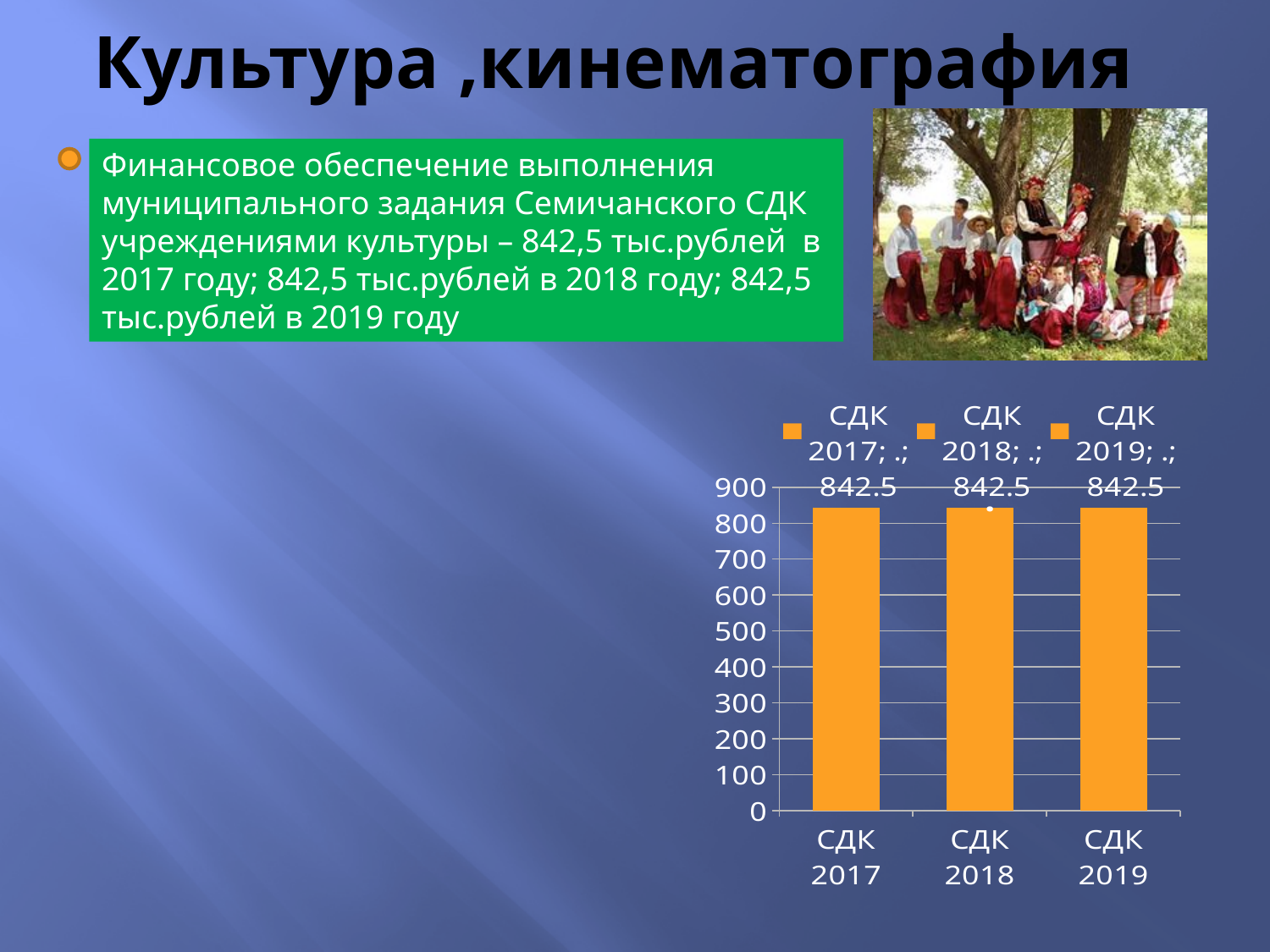
What is the difference between the values for СДК 2018 and СДК 2017? 0 What colour are the bars in the chart? orange What is the highest tick value shown on the vertical axis of the chart? 900 How many bars are plotted in the chart? 3 What is the value for СДК 2018 in the bar chart? 842.5 Do the values rise, fall or stay the same from СДК 2017 to СДК 2019? stay the same What is the value for СДК 2017 in the bar chart? 842.5 What kind of chart is shown on the slide? bar chart Is the value for СДК 2017 greater or less than 900? less Is the value for СДК 2019 greater or less than 800? greater What is the value for СДК 2019 in the bar chart? 842.5